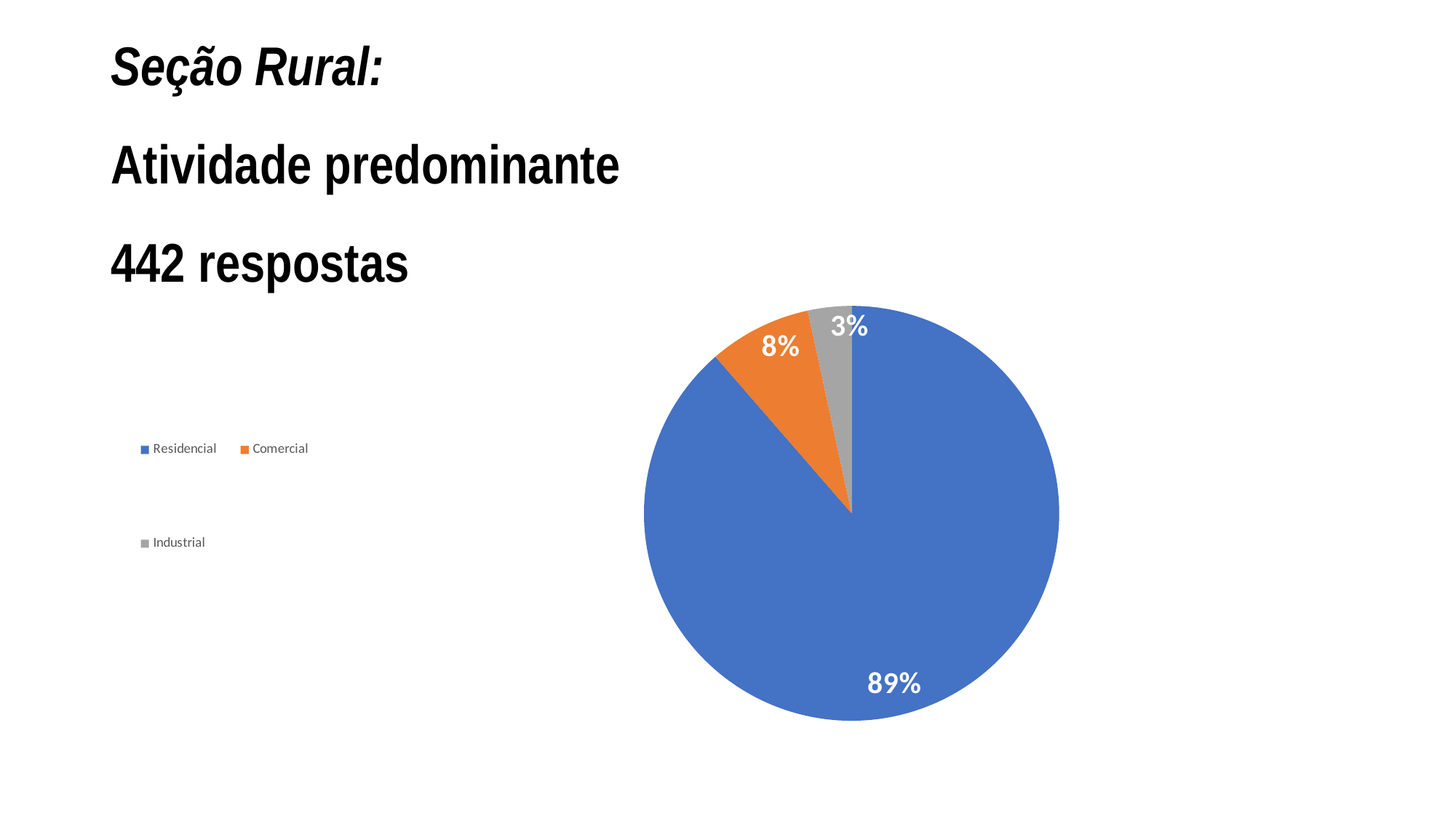
What share of the pie does Industrial have? 3% What share of the pie does Comercial have? 8% Which category has the smallest slice of the pie? Industrial What share of the pie does Residencial have? 89% What is the difference between the Comercial and Industrial shares? 5% Which category has the largest slice of the pie? Residencial What colour is the Residencial slice? blue How many responses does the slide say the chart is based on? 442 respostas How many categories does the pie chart have? 3 What kind of chart is shown on the slide? pie chart Which is larger, the Comercial slice or the Industrial slice? Comercial What is the difference between the Residencial and Comercial shares? 81%